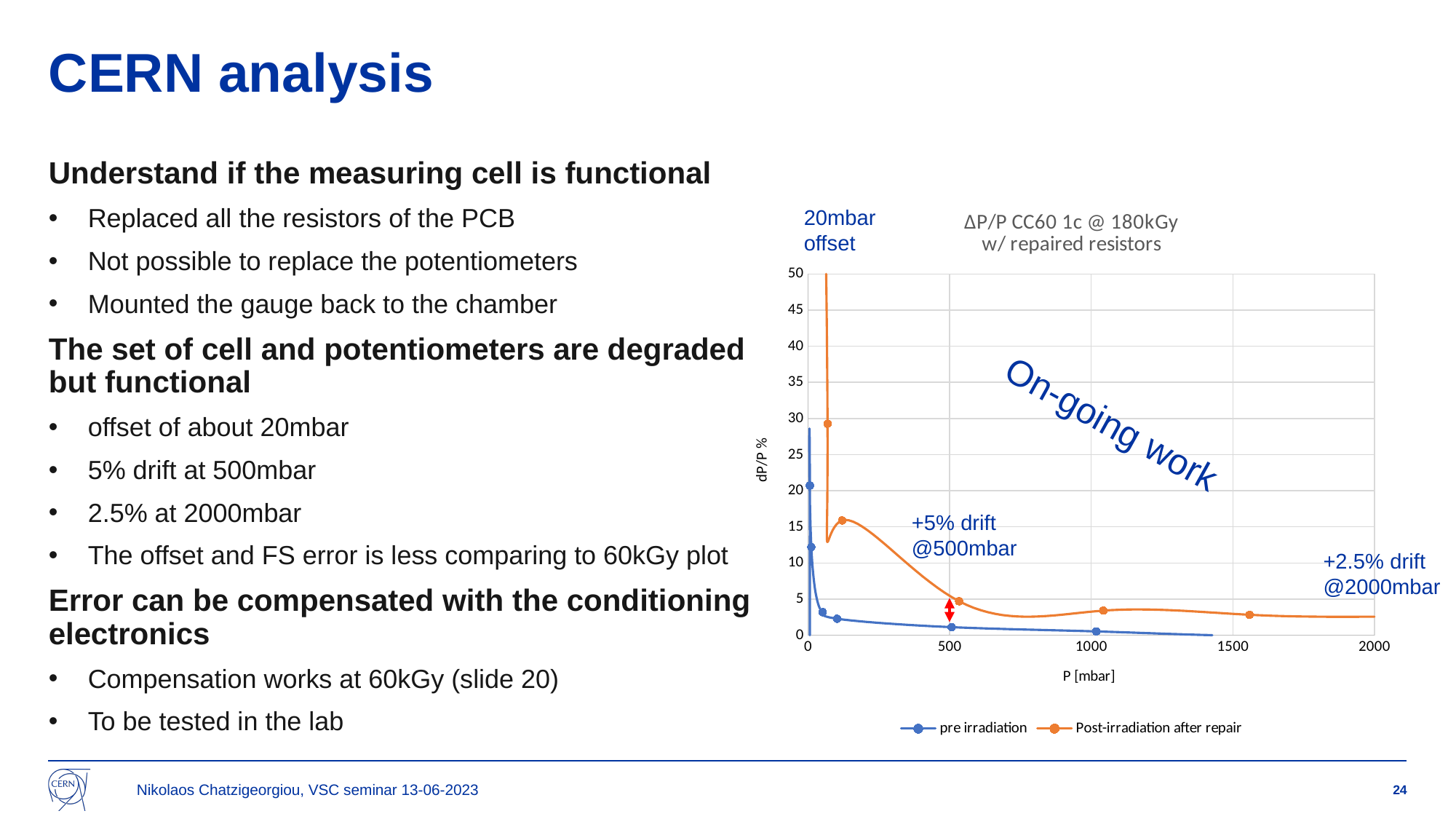
What are the two series named in the chart legend? pre irradiation; Post-irradiation after repair Is the value of the Post-irradiation after repair series at 500 mbar greater or less than 10? less Does the pre irradiation series rise or fall as P increases from 0 to 1500 mbar? fall Is the value of the pre irradiation series at 500 mbar greater or less than 5? less What is the title of the chart? ΔP/P CC60 1c @ 180kGy w/ repaired resistors At 500 mbar, which series has the higher dP/P % value: pre irradiation or Post-irradiation after repair? Post-irradiation after repair Which series reaches the highest dP/P % value on the chart? Post-irradiation after repair Does the Post-irradiation after repair series rise or fall as P increases from about 100 mbar to 500 mbar? fall Is the value of the Post-irradiation after repair series at about 1000 mbar greater or less than 5? less What kind of chart is shown on the slide? line chart How many series does the chart legend list? 2